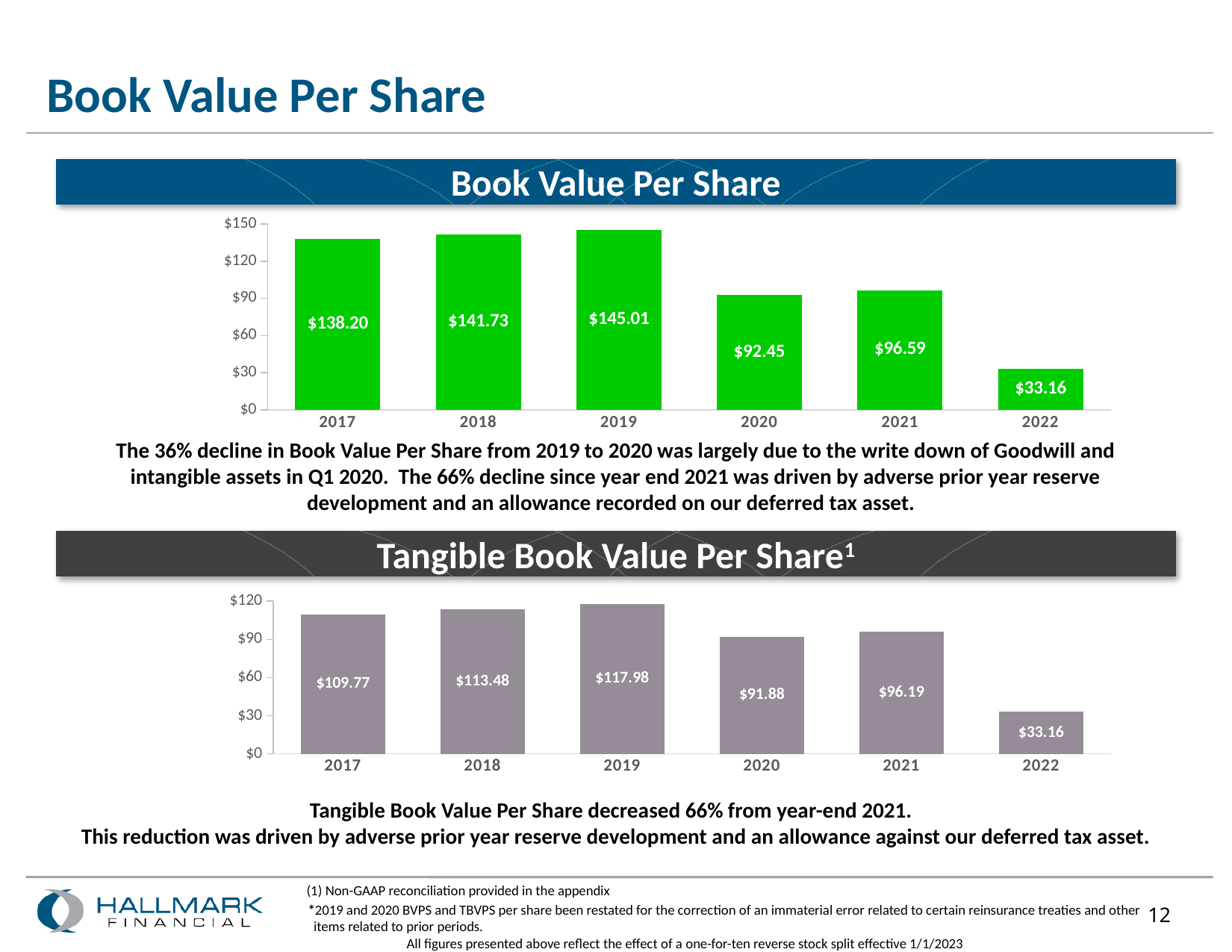
In the Book Value Per Share chart, which year has the lowest value? 2022 In the Book Value Per Share chart, how many years are shown? 6 In the Book Value Per Share chart, which year has the highest value? 2019 What type of chart is the Tangible Book Value Per Share chart? bar chart In the Tangible Book Value Per Share chart, what is the difference between the 2021 and 2022 values? $63.03 In the Book Value Per Share chart, what is the value for 2019? $145.01 In the Tangible Book Value Per Share chart, what is the value for 2017? $109.77 In the Book Value Per Share chart, what is the difference between the 2019 and 2020 values? $52.56 In the Tangible Book Value Per Share chart, what is the value for 2021? $96.19 In the Tangible Book Value Per Share chart, which year has the highest value? 2019 In the Book Value Per Share chart, do the values rise or fall from 2019 to 2022? fall In the Tangible Book Value Per Share chart, is the value for 2020 larger or smaller than the value for 2021? smaller